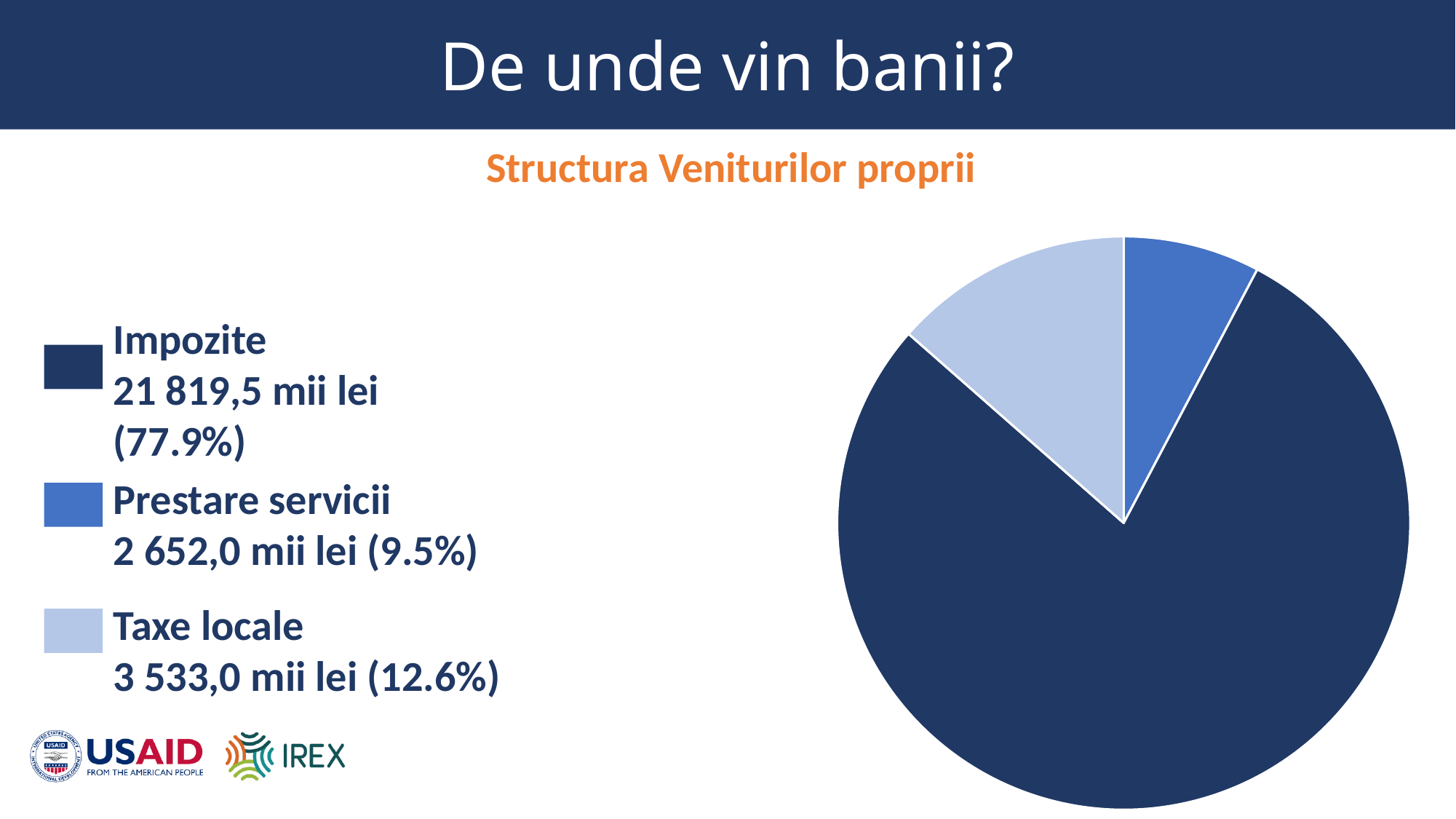
What type of chart is shown on the slide? pie chart What is the value for Impozite? 21 819,5 mii lei What is the title of the chart? Structura Veniturilor proprii What is the value for Taxe locale? 3 533,0 mii lei What share of the pie does Taxe locale represent? 12.6% What is the value for Prestare servicii? 2 652,0 mii lei How many slices does the pie chart have? 3 What is the difference between Taxe locale and Prestare servicii? 881,0 mii lei Which category has the largest slice? Impozite Which category has the smallest slice? Prestare servicii What share of the pie does Impozite represent? 77.9% Which is larger, Taxe locale or Prestare servicii? Taxe locale